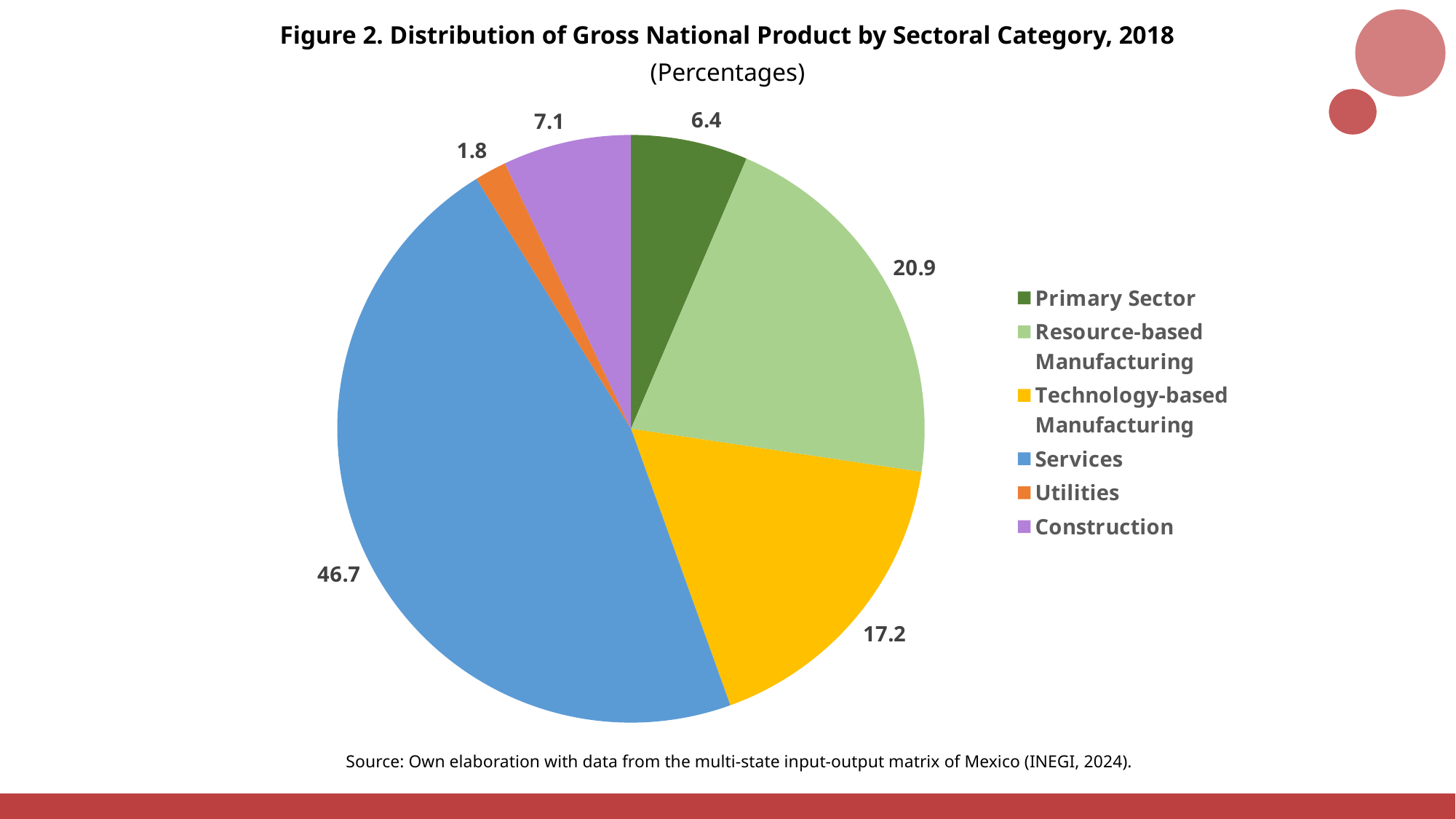
Which sector has the smallest share of the pie? Utilities What is the value for Technology-based Manufacturing? 17.2 What is the value for Resource-based Manufacturing? 20.9 What is the value for Services? 46.7 What kind of chart is shown on the slide? pie chart What colour is the Services slice? blue What is the difference between the values for Resource-based Manufacturing and Technology-based Manufacturing? 3.7 Which is larger, the value for Construction or the value for Primary Sector? Construction Which sector has the largest share of the pie? Services What is the value for Utilities? 1.8 How many slices does the pie chart have? 6 What is the title of the chart? Figure 2. Distribution of Gross National Product by Sectoral Category, 2018